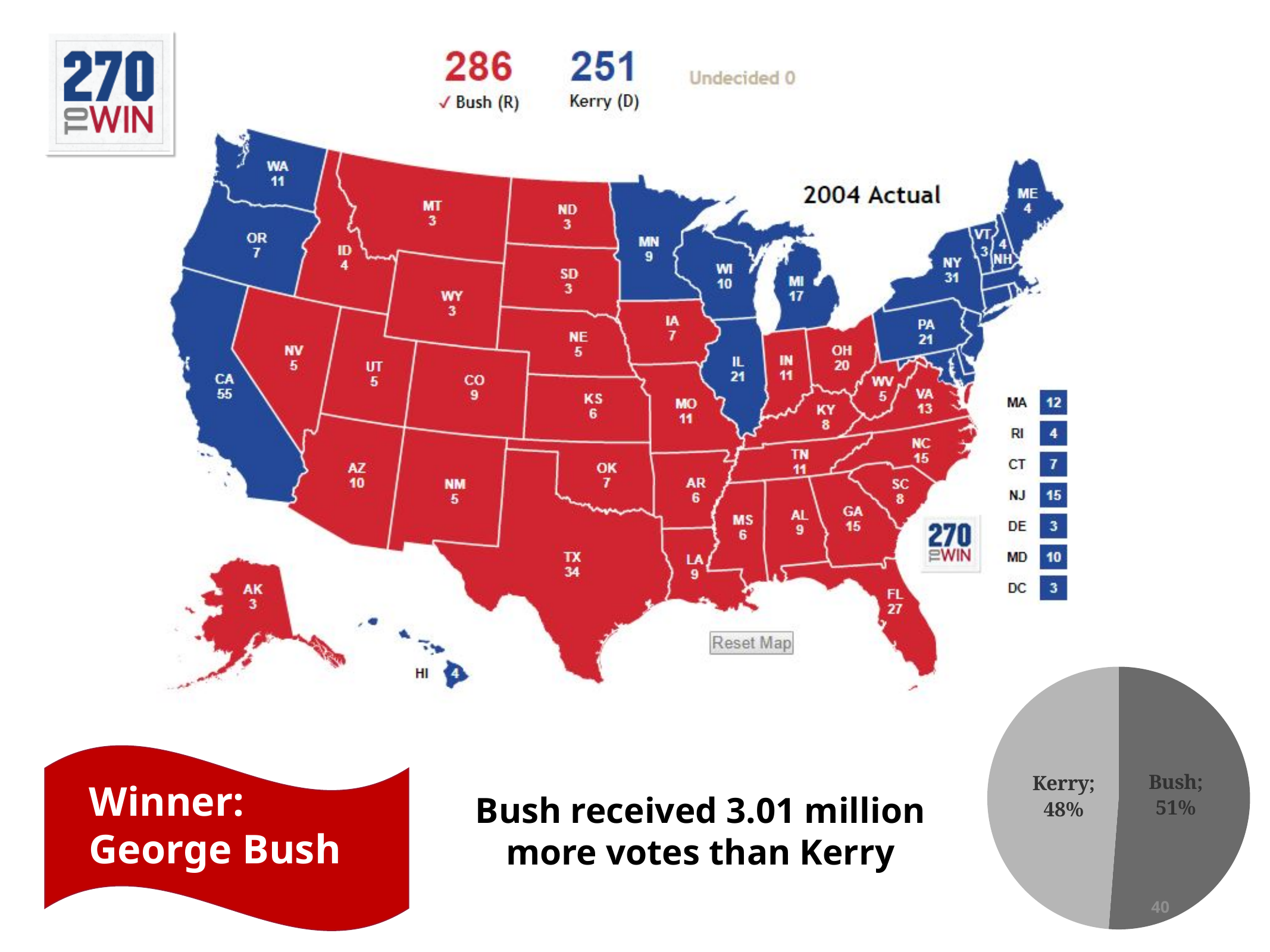
In the pie chart, which slice is larger, Bush or Kerry? Bush What year label appears on the electoral map? 2004 Actual In the pie chart, what share does Bush have? 51% In the pie chart, what is the difference between Bush's share and Kerry's share? 3% How many slices does the pie chart have? 2 In the pie chart, which candidate has the smallest share? Kerry In the electoral map, how many electoral votes are shown for Bush (R)? 286 In the electoral map, how many electoral votes are shown for Kerry (D)? 251 What kind of chart is shown in the bottom-right corner of the slide? pie chart In the electoral map, how many electoral votes does CA have? 55 In the pie chart, what share does Kerry have? 48% In the electoral map, what is the difference between Bush's and Kerry's electoral vote totals? 35